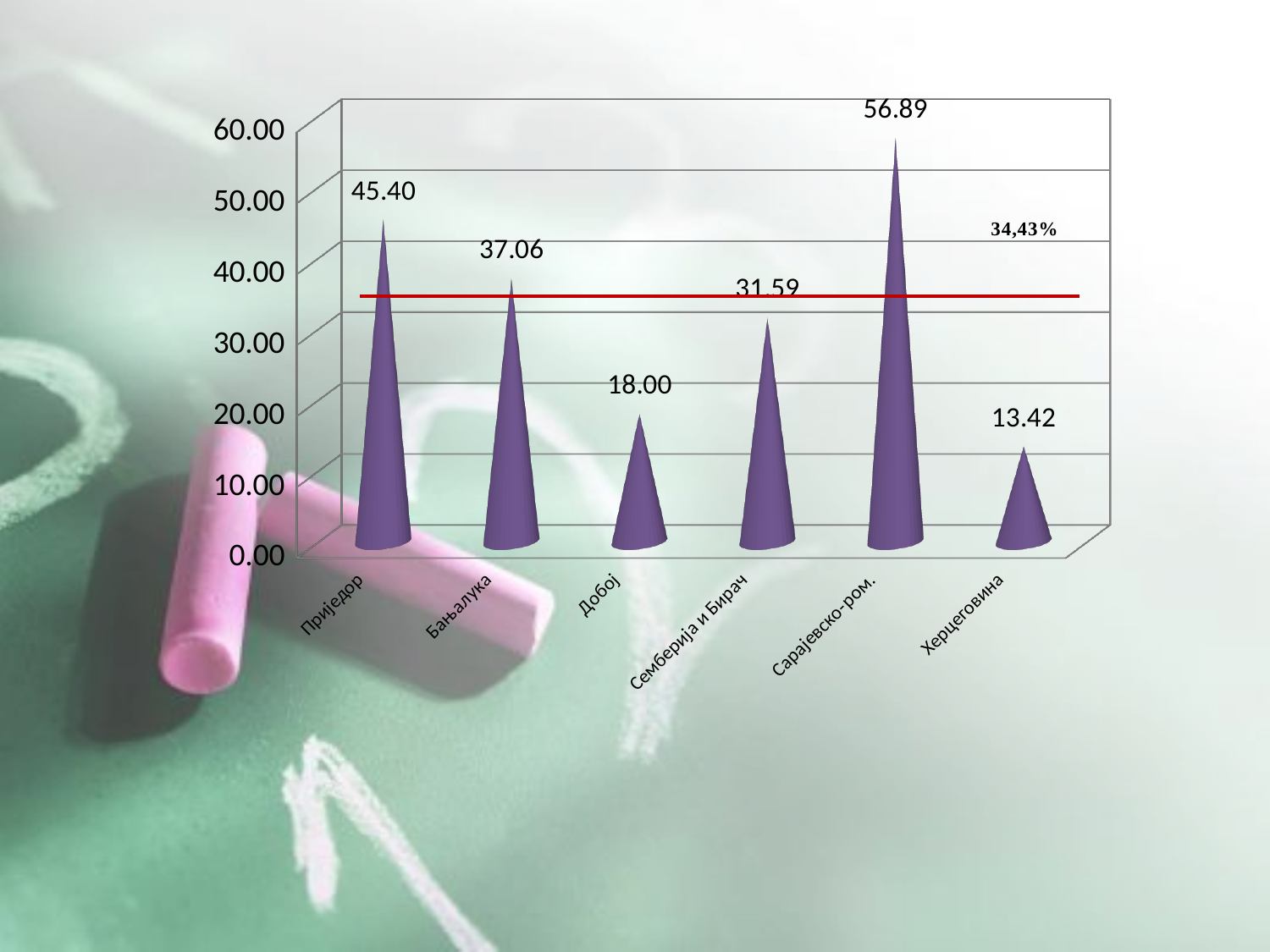
What is the difference between the values for Сарајевско-ром. and Приједор? 11.49 What kind of chart is shown on the slide? Bar chart What value is labelled on the red horizontal line across the chart? 34,43% What is the value for Семберија и Бирач? 31.59 Which category has the highest value? Сарајевско-ром. What is the value for Приједор? 45.40 What is the value for Добој? 18.00 How many categories are shown on the x axis? 6 What is the value for Херцеговина? 13.42 Which category has the lowest value? Херцеговина Which is larger, the value for Бањалука or the value for Семберија и Бирач? Бањалука What is the value for Бањалука? 37.06